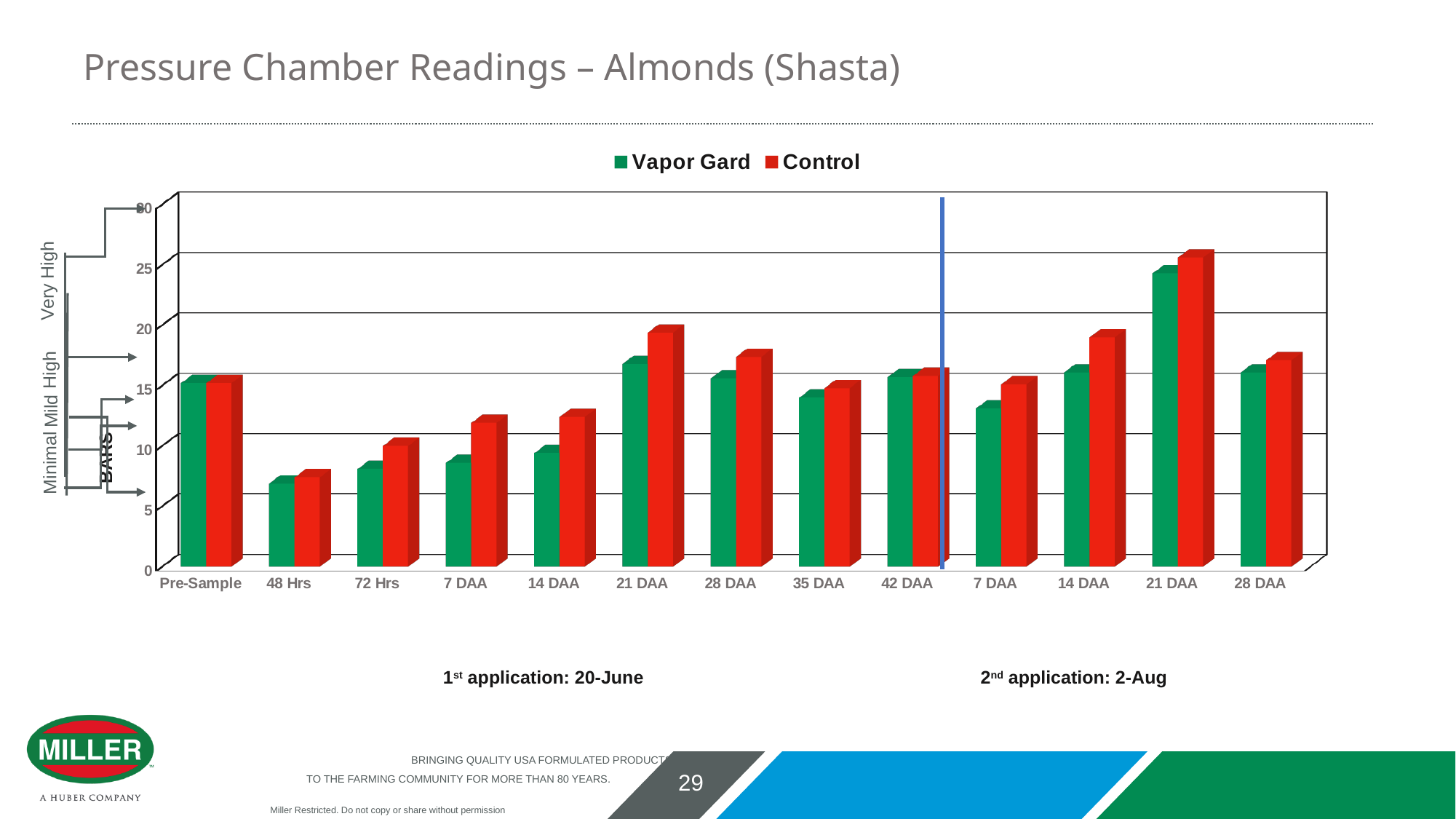
Is the Vapor Gard value at 48 Hrs greater or less than 10? less Which two series are listed in the legend? Vapor Gard and Control What kind of chart is shown on the slide? bar chart At 14 DAA after the 1st application, which series has the larger value, Vapor Gard or Control? Control Which category has the lowest Vapor Gard value? 48 Hrs Is the Vapor Gard value at 21 DAA after the 2nd application greater or less than 20? greater Is the Control value at 21 DAA after the 1st application greater or less than 15? greater How many series does the legend list? 2 Which category has the highest Control value? 21 DAA (after the 2nd application) How many categories are shown along the x axis? 13 What is the title of the slide containing the chart? Pressure Chamber Readings – Almonds (Shasta)